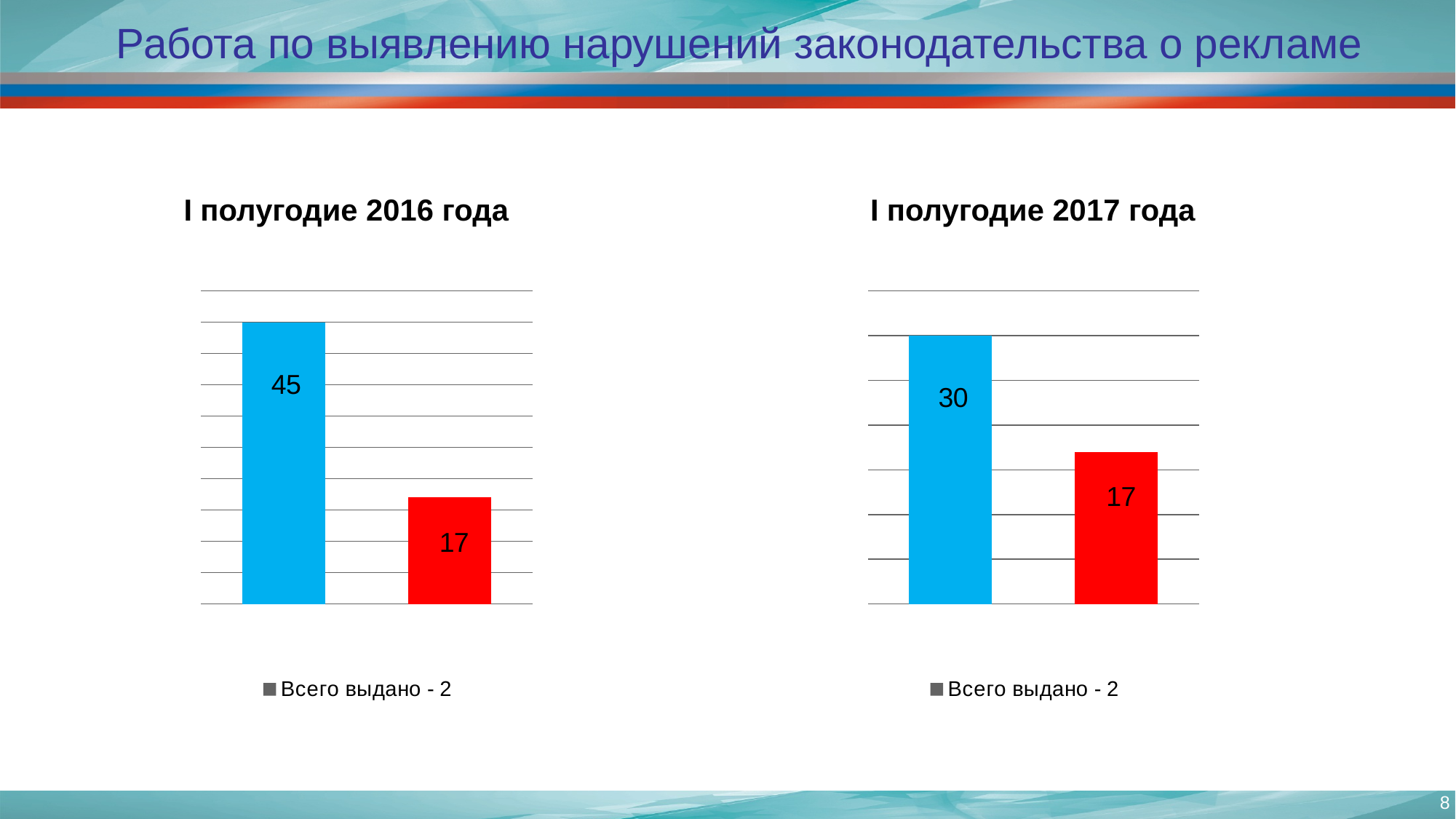
In the chart titled 'I полугодие 2016 года', what value is shown on the red bar? 17 How many bars are plotted in the chart titled 'I полугодие 2017 года'? 2 In the chart titled 'I полугодие 2016 года', which bar is higher, the blue one or the red one? the blue one In the chart titled 'I полугодие 2017 года', what value is shown on the red bar? 17 What is the title of the left chart on the slide? I полугодие 2016 года In the chart titled 'I полугодие 2016 года', what is the difference between the blue bar and the red bar? 28 In the chart titled 'I полугодие 2016 года', what value is shown on the blue bar? 45 What is the legend entry shown under the chart titled 'I полугодие 2017 года'? Всего выдано - 2 In the chart titled 'I полугодие 2017 года', what is the difference between the blue bar and the red bar? 13 In the chart titled 'I полугодие 2017 года', what value is shown on the blue bar? 30 Which chart has the taller blue bar, 'I полугодие 2016 года' or 'I полугодие 2017 года'? I полугодие 2016 года What type of chart is the one titled 'I полугодие 2016 года'? bar chart